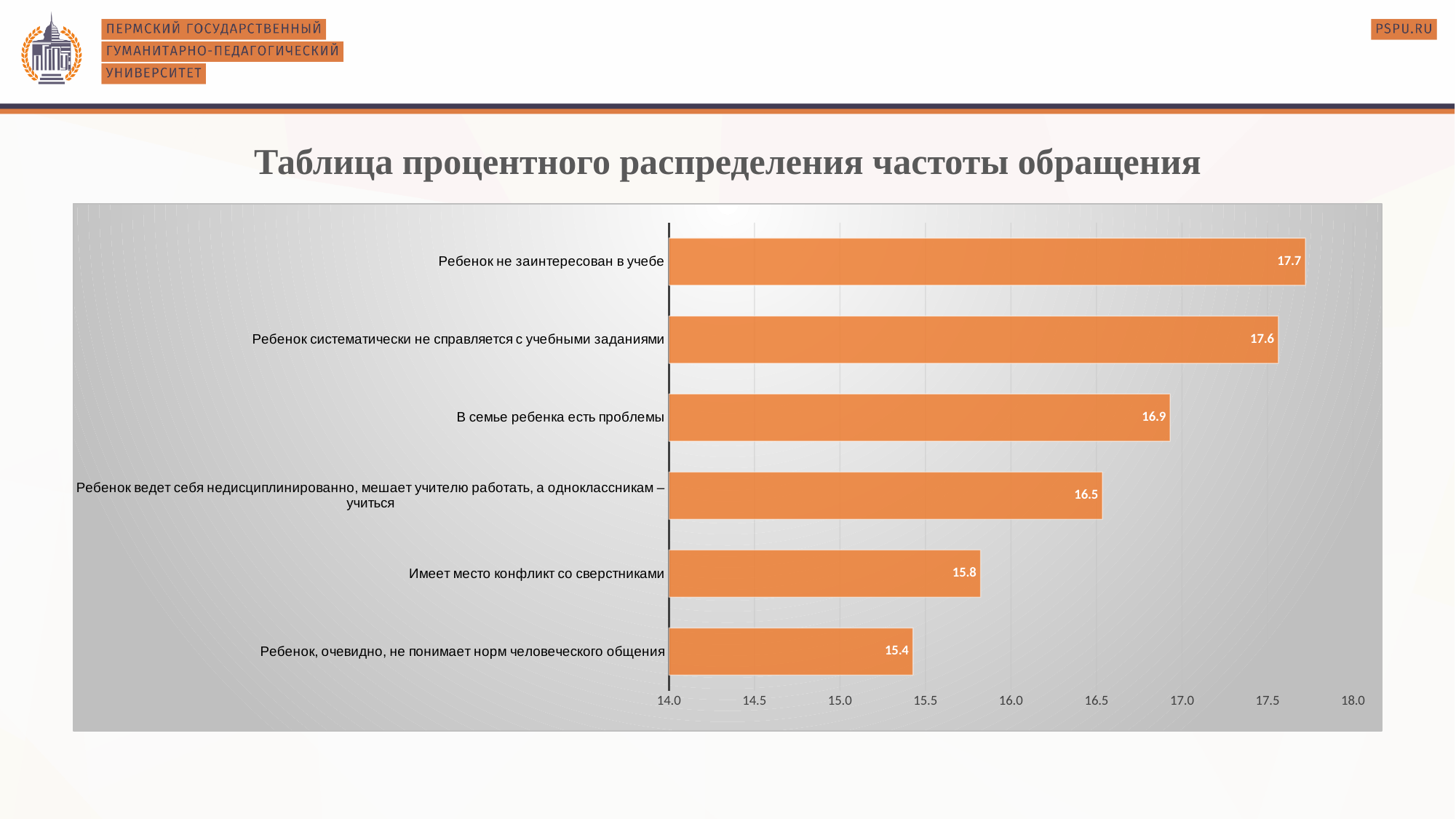
Is the value for "Ребенок ведет себя недисциплинированно, мешает учителю работать, а одноклассникам – учиться" greater or less than 16.0? greater Which category has the lowest value? Ребенок, очевидно, не понимает норм человеческого общения What is the title of the slide? Таблица процентного распределения частоты обращения How many categories are shown in the chart? 6 Which category has the highest value? Ребенок не заинтересован в учебе What is the value for "Ребенок, очевидно, не понимает норм человеческого общения"? 15.4 What is the value for "В семье ребенка есть проблемы"? 16.9 What is the value for "Имеет место конфликт со сверстниками"? 15.8 What kind of chart is shown on the slide? bar chart What is the difference between the values for "Ребенок систематически не справляется с учебными заданиями" and "Имеет место конфликт со сверстниками"? 1.8 Which is larger: the value for "В семье ребенка есть проблемы" or the value for "Ребенок ведет себя недисциплинированно, мешает учителю работать, а одноклассникам – учиться"? В семье ребенка есть проблемы What is the value for "Ребенок не заинтересован в учебе"? 17.7